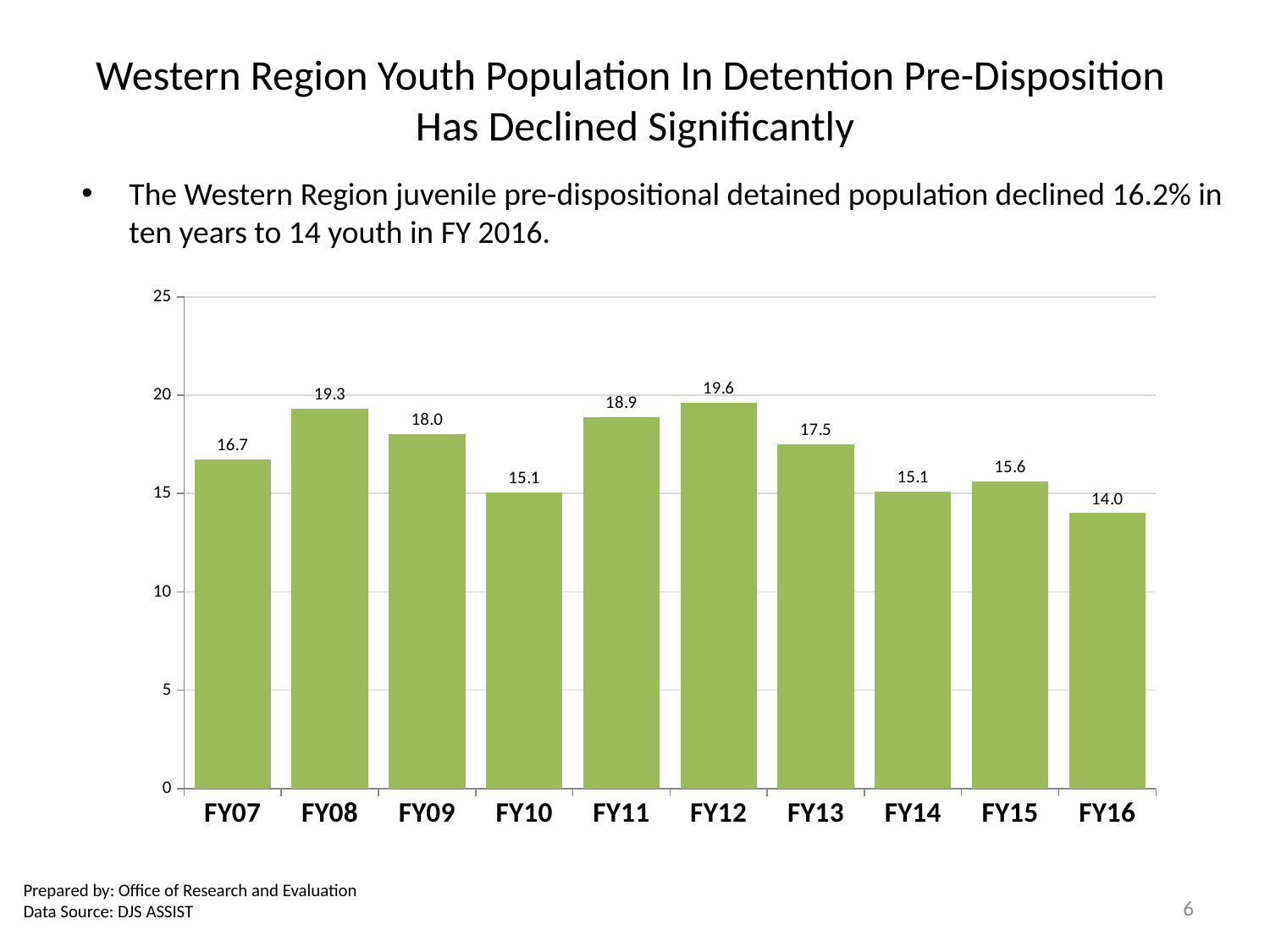
Which fiscal year has the lowest value? FY16 What is the difference between the values for FY07 and FY16? 2.7 Is the value for FY10 greater or less than 20? less Do the values rise or fall from FY12 to FY16? fall How many fiscal years are shown on the x axis? 10 Which fiscal year has the highest value? FY12 What is the value for FY12? 19.6 What kind of chart is shown on the slide? bar chart What is the value for FY07? 16.7 Which is larger, the value for FY11 or the value for FY13? FY11 What is the value for FY16? 14.0 What is the difference between the values for FY08 and FY09? 1.3